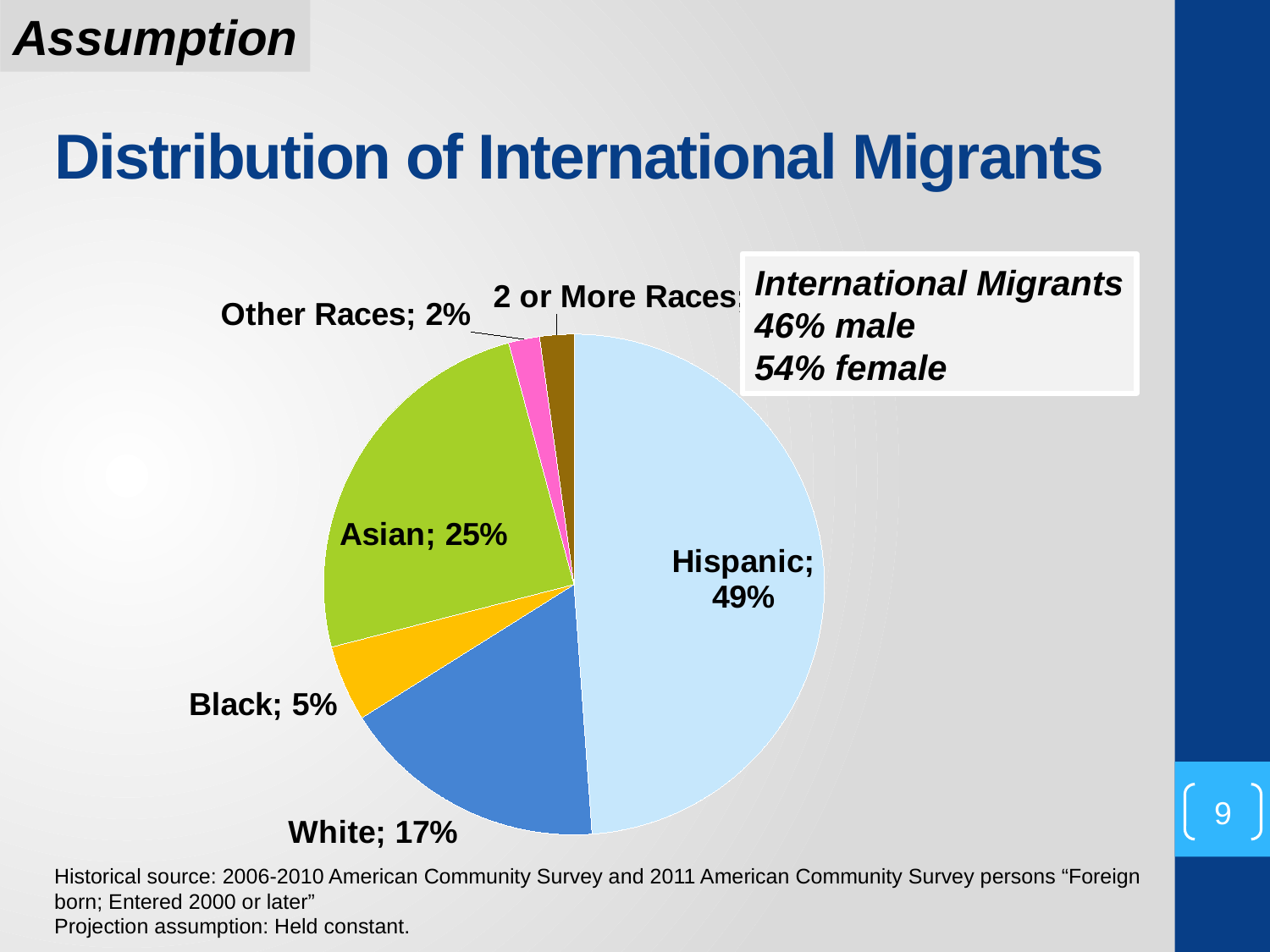
How many slices does the pie chart have? 6 What is the difference in percentage points between the White and Black slices? 12 What is the value shown for Black? 5% What share of international migrants is Hispanic? 49% Which is larger, the Asian slice or the White slice? Asian What type of chart is shown on the slide? Pie chart What percentage of the pie is labelled Asian? 25% What is the value shown for Other Races? 2% What is the title of the chart on the slide? Distribution of International Migrants Which category has the largest slice of the pie? Hispanic What is the difference in percentage points between the Hispanic and Asian slices? 24 What is the value shown for White? 17%